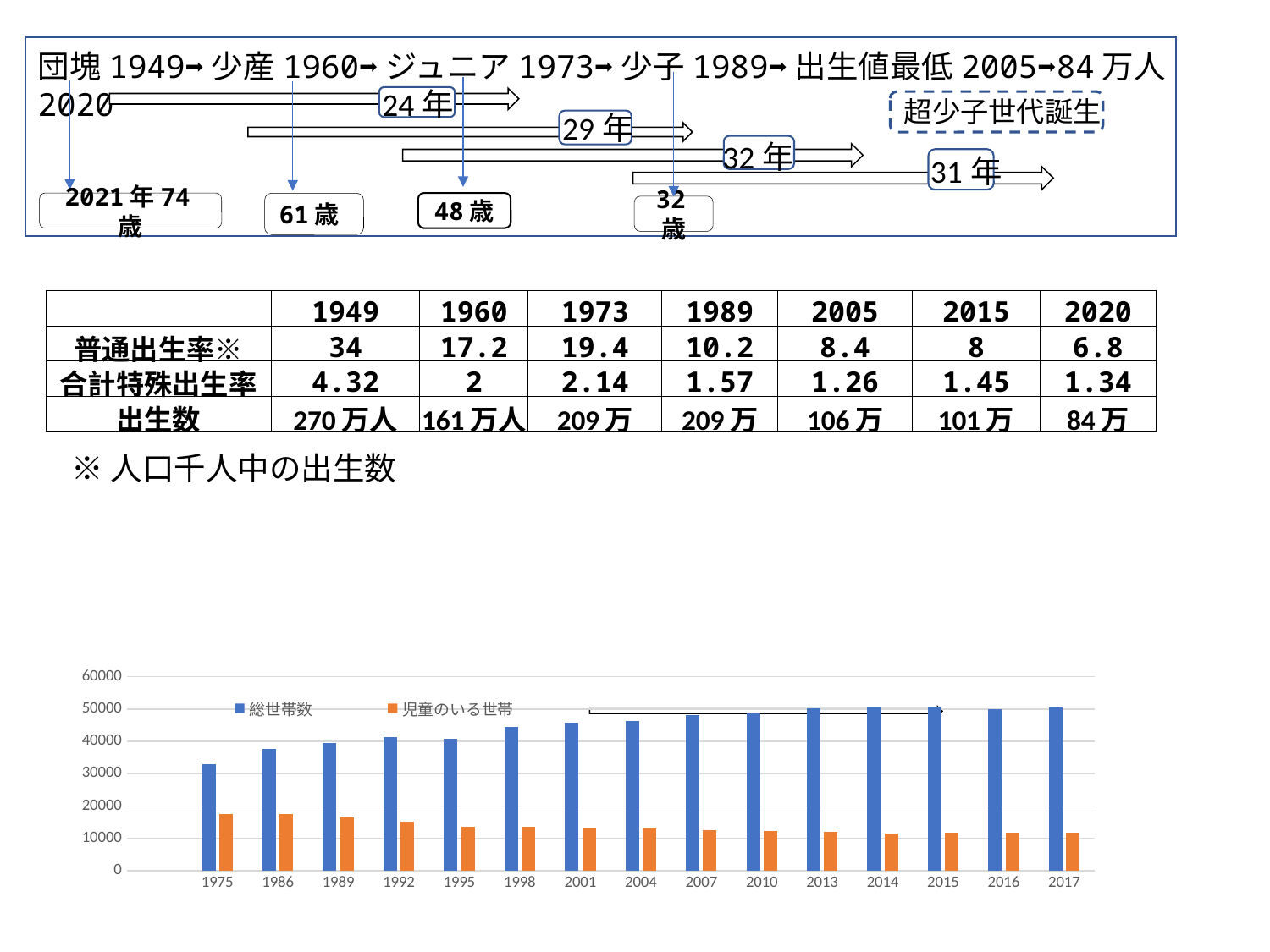
In the bar chart, is the value for 総世帯数 in 2017 greater or less than 40000? greater How many series does the legend of the bar chart list? 2 In the bar chart, which series is shown in orange? 児童のいる世帯 In the bar chart, which series is shown in blue? 総世帯数 In the bar chart, is the value for 総世帯数 in 1975 greater or less than 40000? less In the bar chart, is the value for 児童のいる世帯 in 1975 greater or less than 20000? less In the bar chart, do the values for 総世帯数 generally rise or fall from 1975 to 2017? rise In the bar chart, which year has the lowest value for 総世帯数? 1975 How many years are shown on the x axis of the bar chart? 15 What kind of chart is shown at the bottom of the slide? bar chart In the bar chart, do the values for 児童のいる世帯 generally rise or fall from 1975 to 2017? fall In the bar chart, which is larger in 2010: 総世帯数 or 児童のいる世帯? 総世帯数